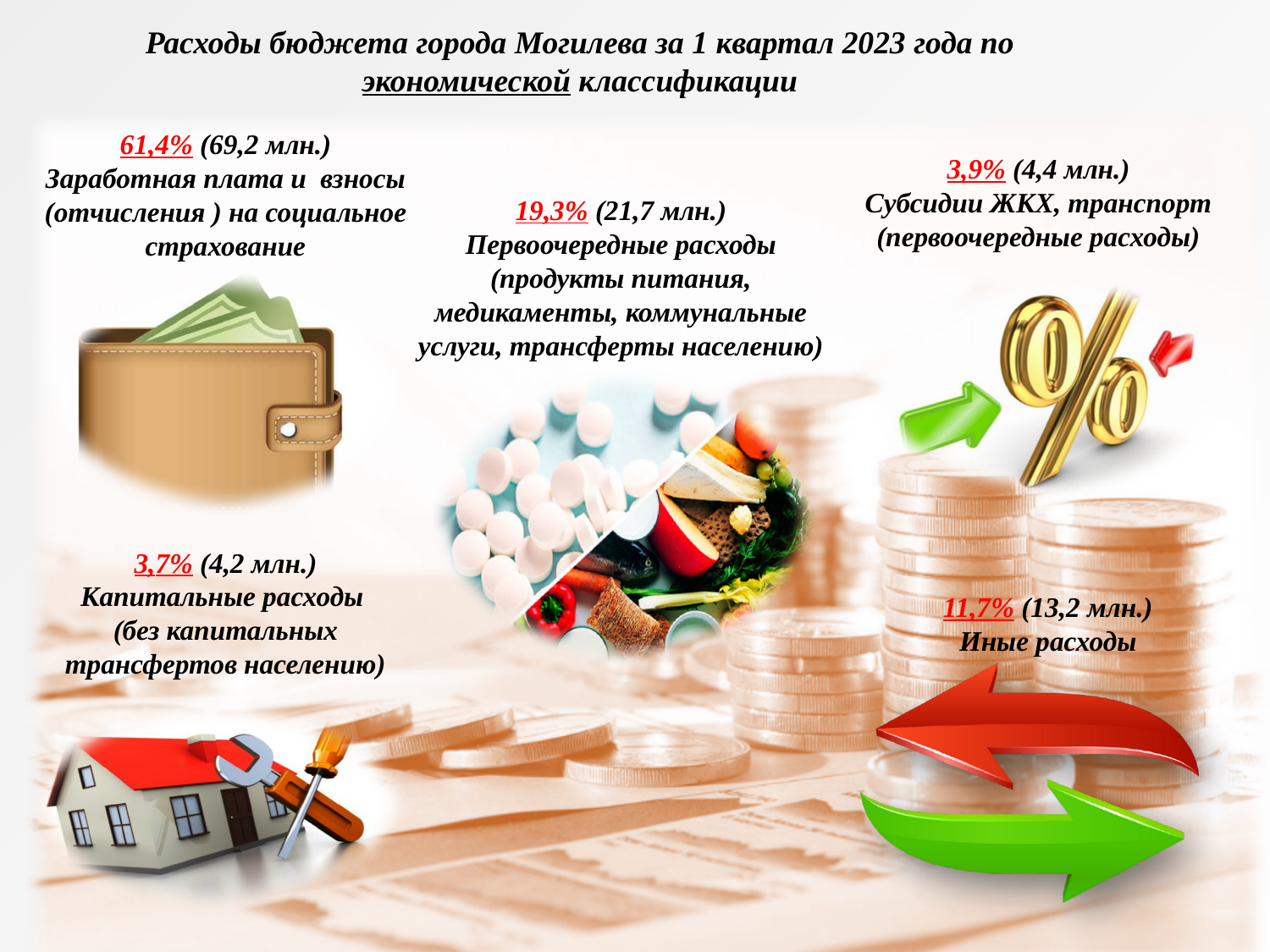
Which expenditure category has the smallest share? Капитальные расходы What is the amount in millions for other expenditures (Иные расходы)? 13,2 млн. How many expenditure categories are shown on the slide? 5 What is the amount in millions for priority expenditures (Первоочередные расходы)? 21,7 млн. What share of Mogilev city budget expenditures for Q1 2023 goes to wages and social insurance contributions (Заработная плата и взносы на социальное страхование)? 61,4% What is the difference in percentage points between wages and social insurance contributions (61,4%) and priority expenditures (19,3%)? 42,1 What percentage is shown for capital expenditures (Капитальные расходы)? 3,7% What period and city does the slide title refer to? Город Могилев, 1 квартал 2023 года What percentage is shown for subsidies for housing and utilities and transport (Субсидии ЖКХ, транспорт)? 3,9% What is the difference in millions between other expenditures (13,2 млн.) and subsidies for housing and utilities and transport (4,4 млн.)? 8,8 млн. Which is larger: the share for subsidies for housing and utilities and transport or the share for capital expenditures? Субсидии ЖКХ, транспорт Which expenditure category has the largest share? Заработная плата и взносы на социальное страхование